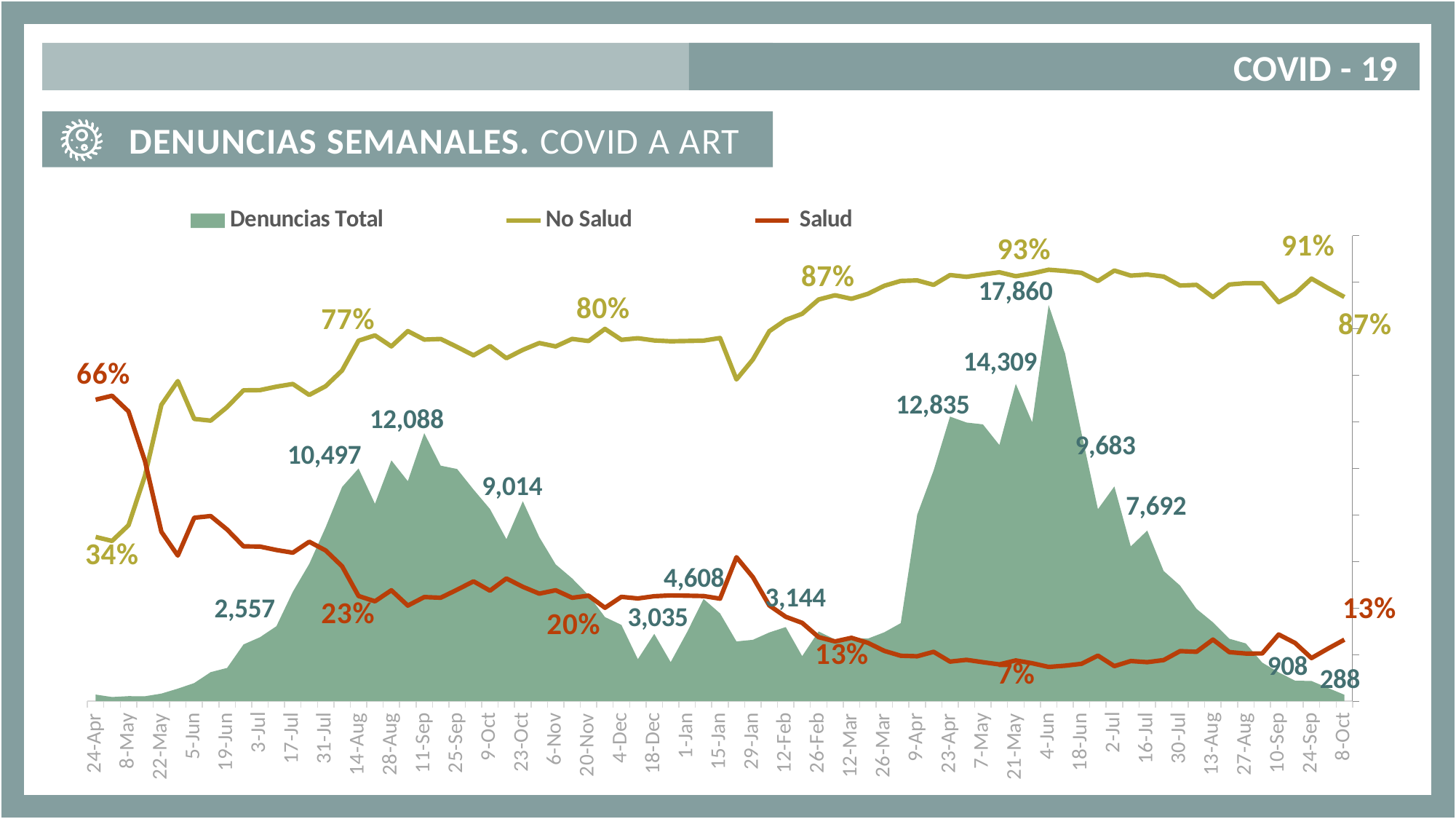
What is the lowest labelled value of Denuncias Total? 288 What is the highest labelled value of Denuncias Total? 17,860 What is the first labelled value of the No Salud line, at 24-Apr? 34% What is the highest labelled value on the No Salud line? 93% What is the last labelled value of the No Salud line, at 8-Oct? 87% Which is larger at 24-Apr, the Salud share or the No Salud share? Salud What is the first labelled value of the Salud line, at 24-Apr? 66% What is the difference between the two labelled peaks 17,860 and 12,088 of Denuncias Total? 5,772 How many series does the legend list? 3 What is the labelled value of Denuncias Total at the peak near 11-Sep? 12,088 Does the No Salud line generally rise or fall from 24-Apr to 8-Oct? rise What is the last labelled value of the Salud line, at 8-Oct? 13%